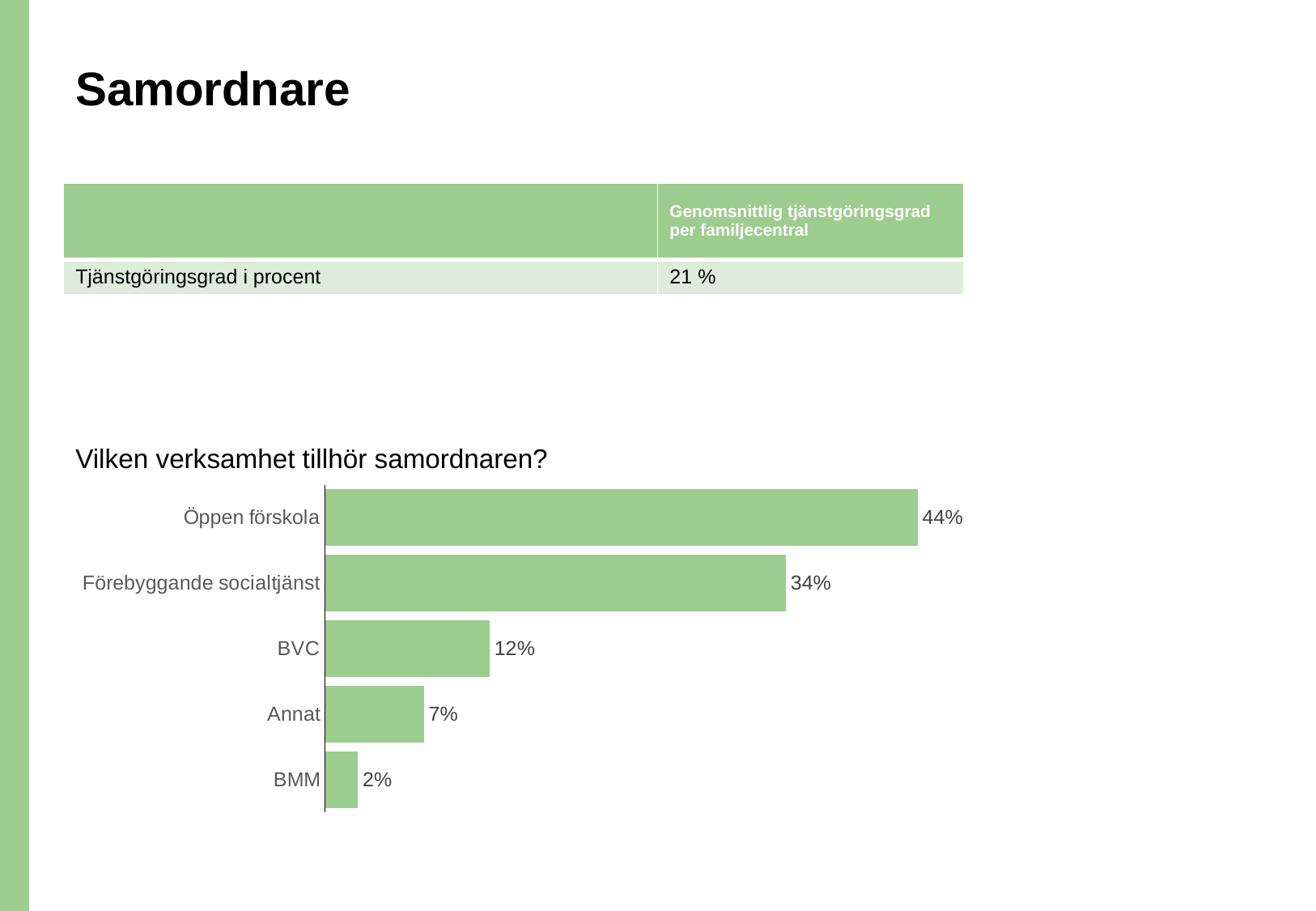
How many categories are shown in the chart? 5 What kind of chart is shown on the slide? Bar chart What is the value for BVC? 12% What is the question shown as the title above the chart? Vilken verksamhet tillhör samordnaren? What is the difference between the values for Öppen förskola and Förebyggande socialtjänst? 10% What is the value for BMM? 2% Which category has the highest value? Öppen förskola What is the value for Öppen förskola? 44% Which category has the lowest value? BMM What is the value for Förebyggande socialtjänst? 34% Which is larger, the value for Annat or the value for BVC? BVC What is the difference between the values for BVC and Annat? 5%